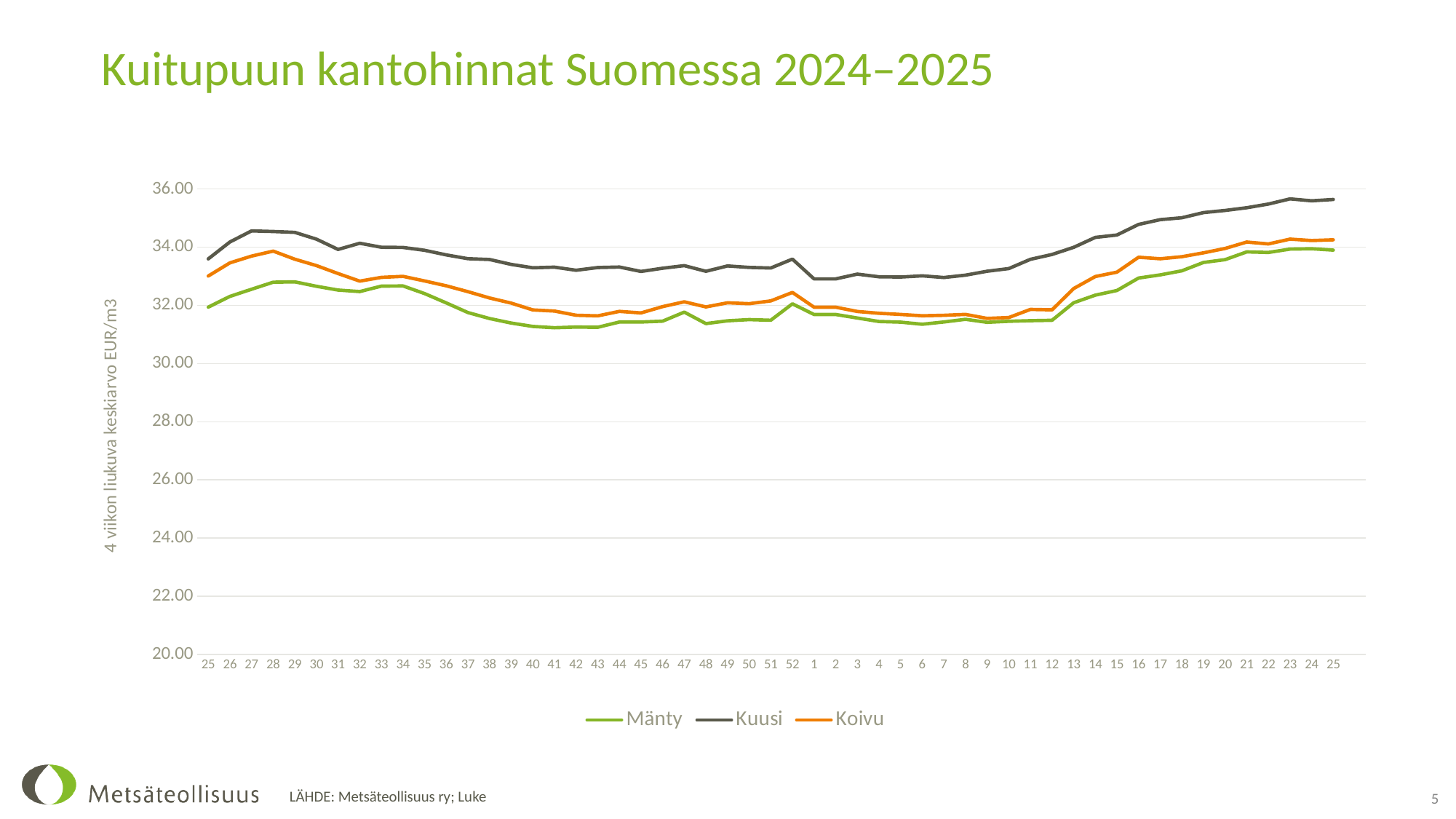
Does the Mänty line rise or fall from week 28 to week 40? fall How many series does the legend list? 3 Is the value for Kuusi at week 1 greater or less than 34.00? less Is the value for Koivu at week 23 greater or less than 34.00? greater Which series has the lowest value at week 40? Mänty Is the value for Kuusi at week 27 greater or less than 34.00? greater At week 30, which is higher, Kuusi or Mänty? Kuusi What is the title of the vertical axis? 4 viikon liukuva keskiarvo EUR/m3 Which series has the highest value at week 25 at the right end of the x axis? Kuusi What kind of chart is shown on the slide? line chart Does the Kuusi line rise or fall from week 12 to week 25 at the right end of the chart? rise